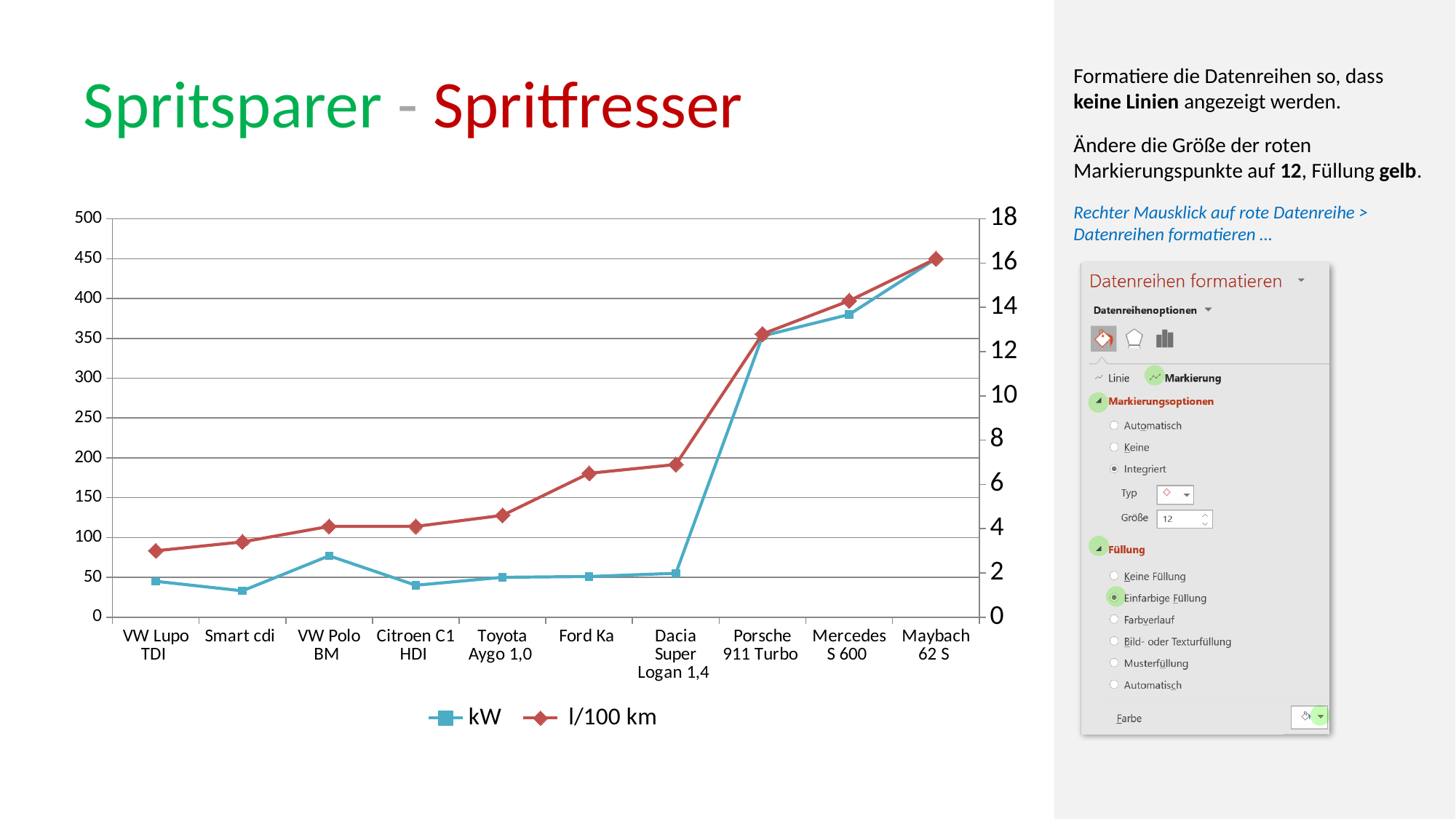
Which car has the highest kW value? Maybach 62 S What kind of chart is shown on the slide? line chart Is the kW value for Porsche 911 Turbo greater or less than 300? greater Which car has the lowest l/100 km value? VW Lupo TDI Is the kW value for VW Polo BM greater or less than 100? less Which has the larger kW value, VW Polo BM or Citroen C1 HDI? VW Polo BM Is the l/100 km value for Porsche 911 Turbo greater or less than 10? greater How many series does the chart legend list? 2 How many car models are plotted along the x axis? 10 Which car has the highest l/100 km value? Maybach 62 S Which car has the lowest kW value? Smart cdi Which series is drawn in red with diamond markers? l/100 km